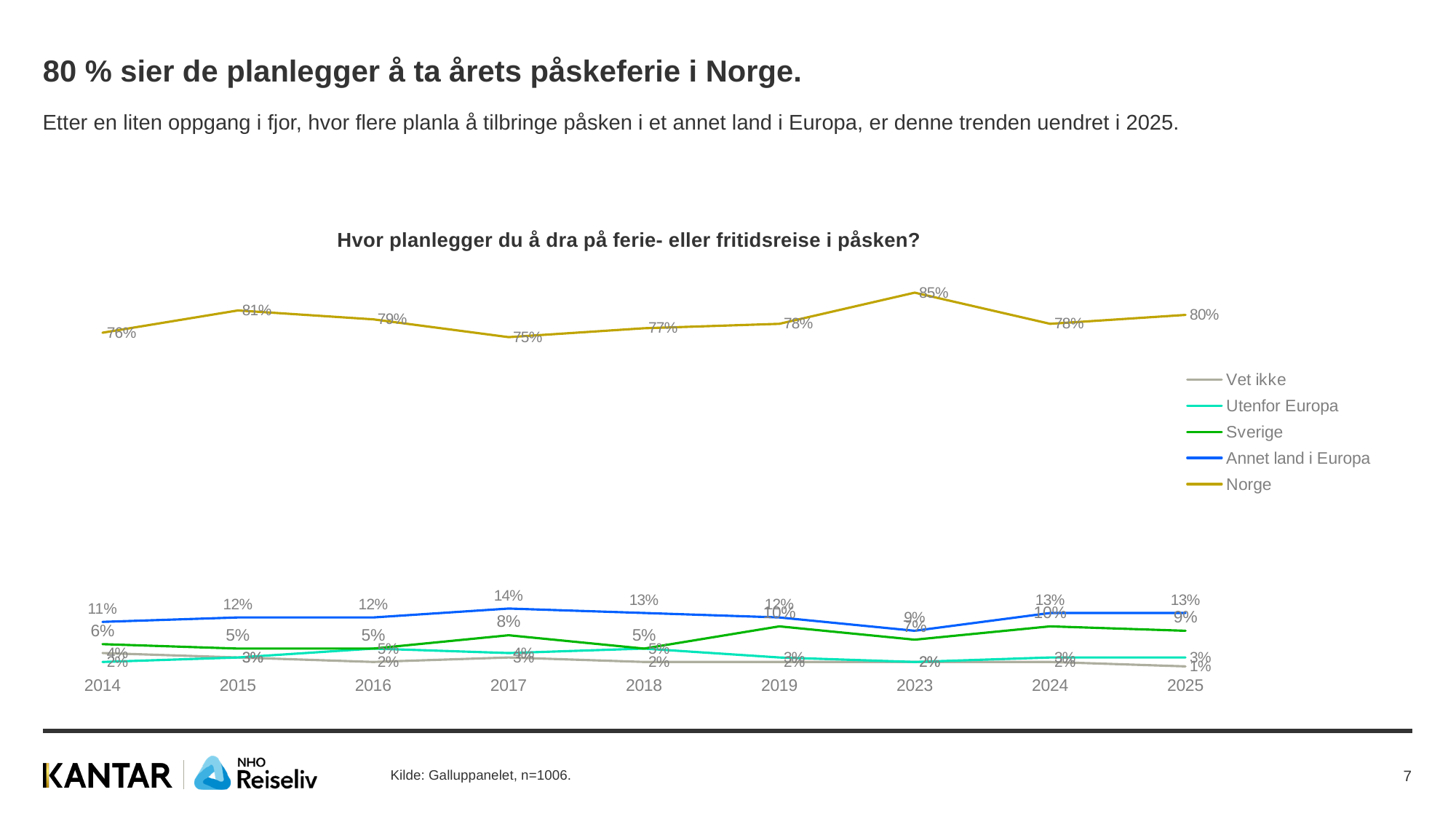
What is the value for Sverige in 2019? 10% Which is larger in 2025, the value for Annet land i Europa or the value for Sverige? Annet land i Europa What is the value for Norge in 2023? 85% In which year is the value for Norge lowest? 2017 What type of chart is shown on the slide? line chart In which year is the value for Norge highest? 2023 What is the title of the chart? Hvor planlegger du å dra på ferie- eller fritidsreise i påsken? What is the value for Norge in 2025? 80% What is the value for Annet land i Europa in 2017? 14% How many years are shown on the x axis? 9 How many series does the legend list? 5 What is the difference between the Norge values in 2023 and 2024? 7%